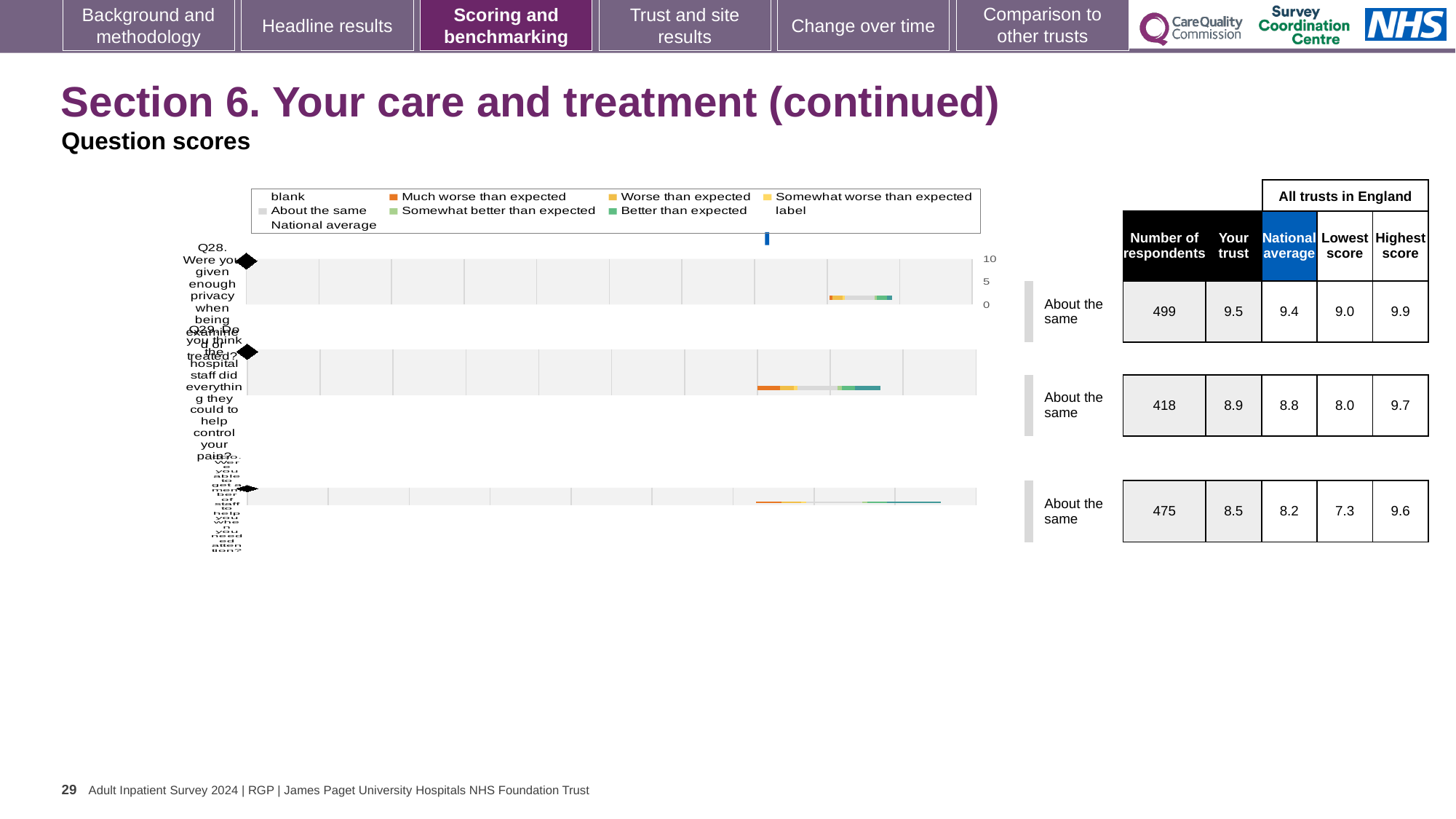
For the third chart (Q30), what is the difference between the 'Your trust' score and the national average? 0.3 What kind of chart is used for the question scores on this slide? Bar chart How many question charts are shown on the slide? 3 For the Q28 chart, what is the highest score among all trusts in England? 9.9 Is the 'Your trust' score higher for Q28 or for Q29? Q28 In the Q28 chart (privacy when being examined or treated), what is the 'Your trust' score shown in the table? 9.5 Which of the three questions on the slide has the fewest respondents? Q29 For the third chart (Q30), what is the lowest score among all trusts in England? 7.3 In the Q29 chart (staff did everything to help control pain), what is the national average score? 8.8 Which of the three questions on the slide has the highest 'Your trust' score? Q28 For the third chart (Q30), how many respondents are listed? 475 What benchmark category is shown next to the Q29 chart? About the same